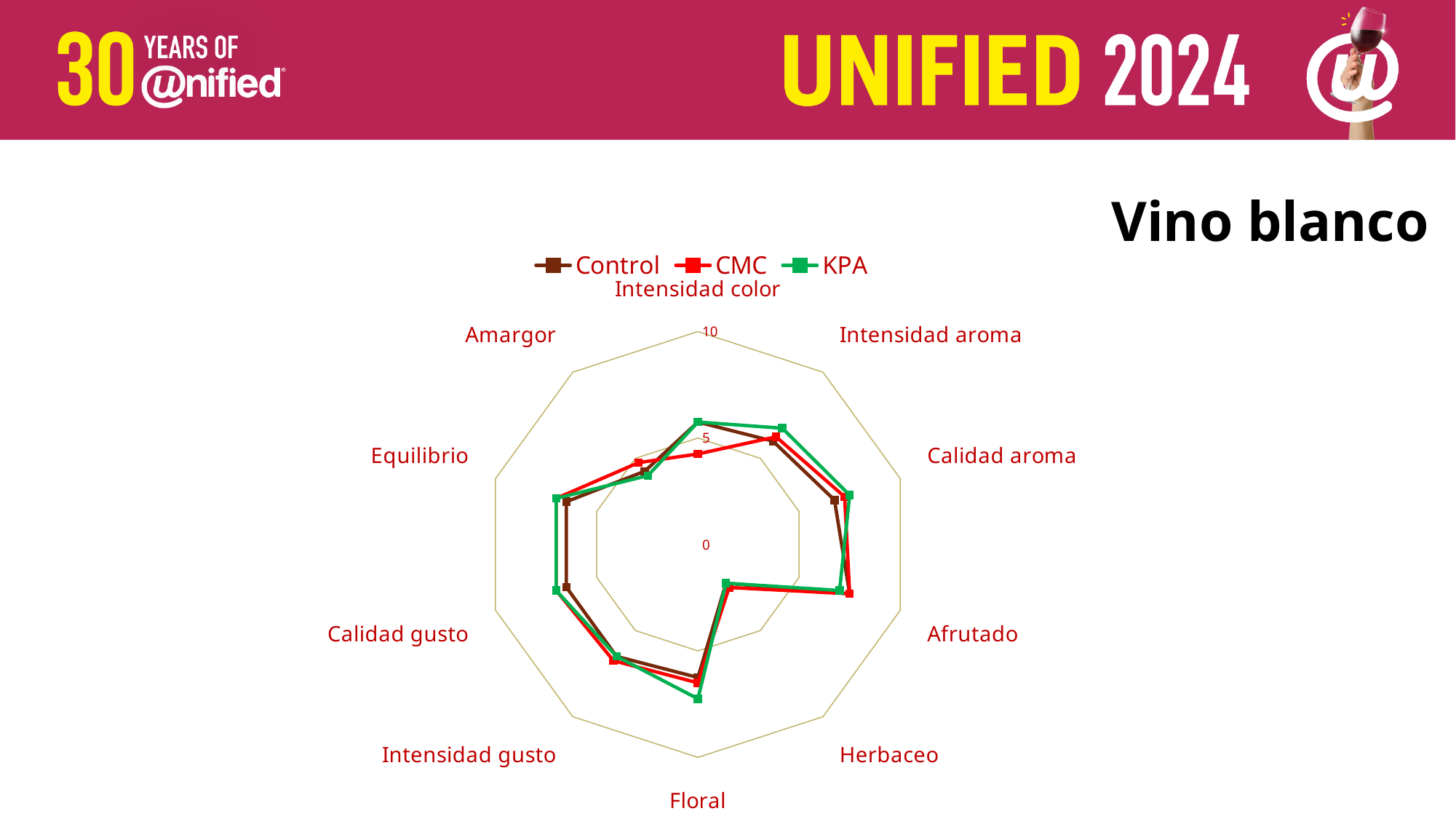
How many series does the legend list? 3 Is the value for Herbaceo in the KPA series greater or less than 5? less For the KPA series, which category has the lowest value? Herbaceo Which series are listed in the legend? Control, CMC, KPA What kind of chart is shown on the slide? Radar chart What is the title shown on the slide next to the chart? Vino blanco For the Control series, which is larger: the value for Calidad gusto or the value for Herbaceo? Calidad gusto How many categories (axes) does the radar chart have? 10 Is the value for Calidad aroma in the Control series greater or less than 5? greater Is the value for Equilibrio in the KPA series greater or less than 5? greater